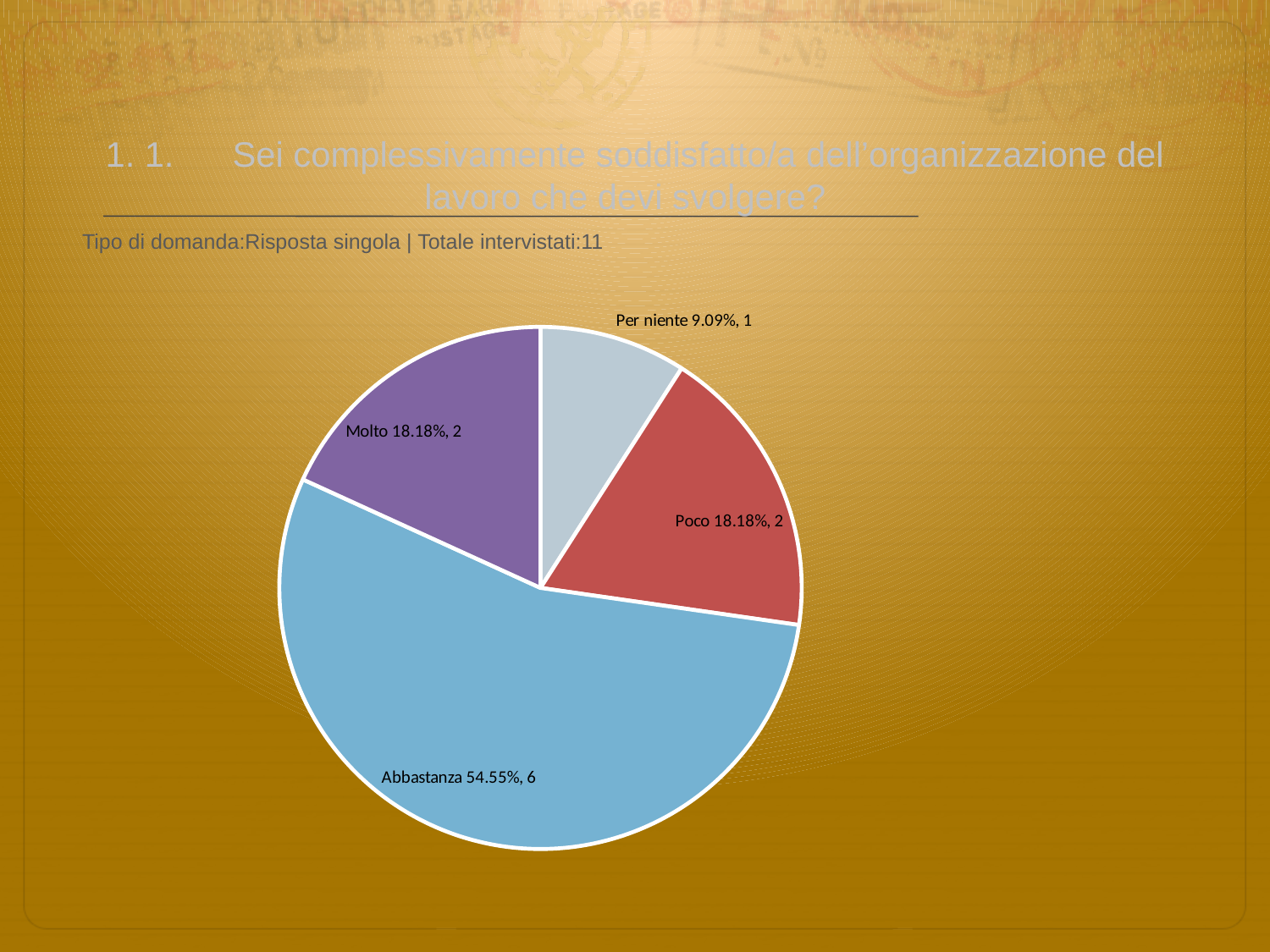
How many respondents answered Per niente? 1 How many respondents answered Poco? 2 What percentage share does the Molto slice have? 18.18% Which category has the largest slice of the pie? Abbastanza Which category has the smallest slice of the pie? Per niente How many slices does the pie chart have? 4 What is the total number of respondents across all slices? 11 What kind of chart is shown on the slide? pie chart What is the difference in respondent count between Abbastanza and Molto? 4 What colour is the Abbastanza slice? light blue Which has more respondents, Poco or Per niente? Poco What percentage share does the Abbastanza slice have? 54.55%